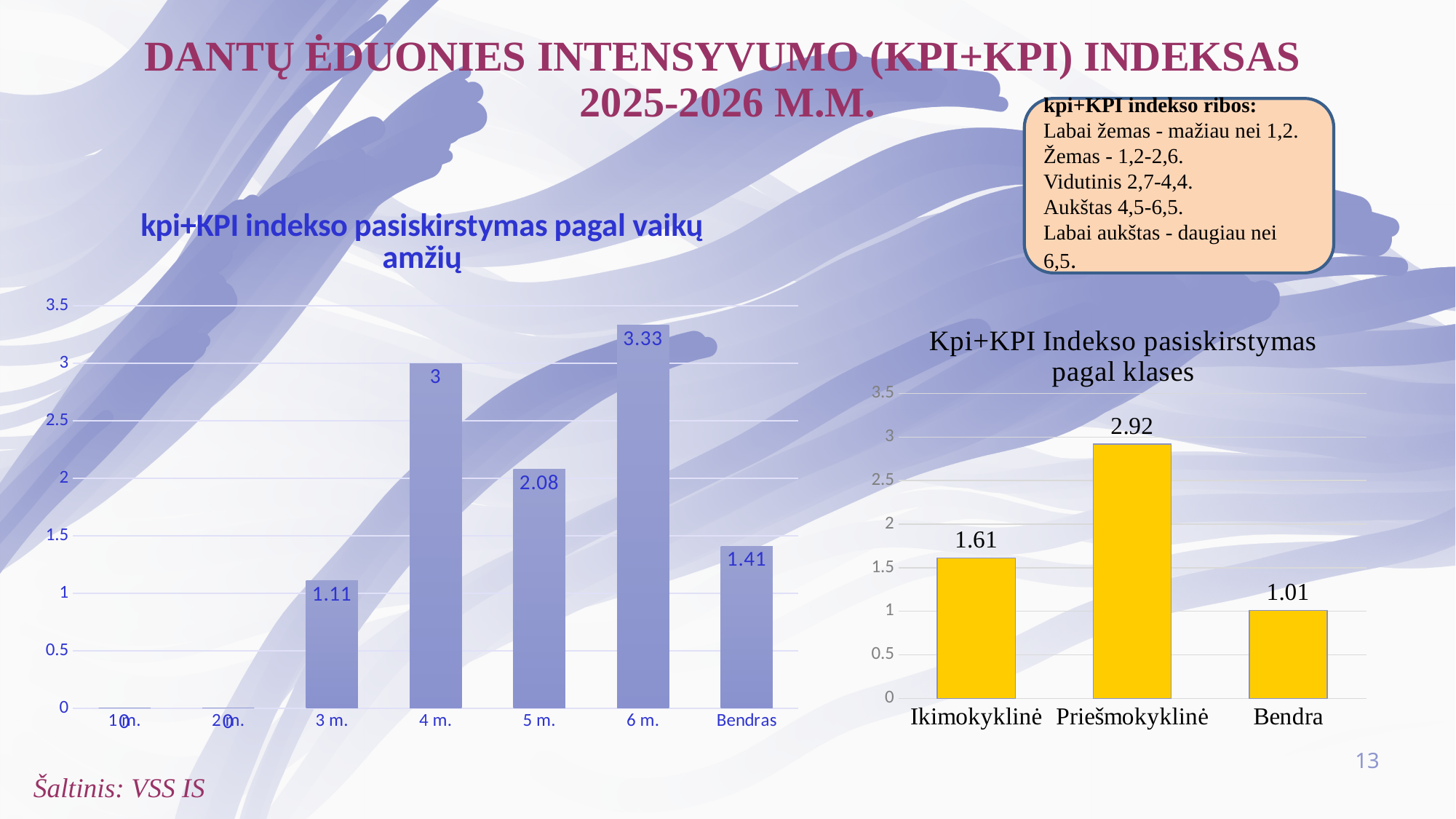
In the chart titled "Kpi+KPI Indekso pasiskirstymas pagal klases", which category has the lowest value? Bendra In the chart titled "kpi+KPI indekso pasiskirstymas pagal vaikų amžių", what is the value for 3 m.? 1.11 In the chart titled "kpi+KPI indekso pasiskirstymas pagal vaikų amžių", what is the difference between the values for 4 m. and 5 m.? 0.92 In the chart titled "Kpi+KPI Indekso pasiskirstymas pagal klases", what is the difference between the values for Priešmokyklinė and Ikimokyklinė? 1.31 In the chart titled "kpi+KPI indekso pasiskirstymas pagal vaikų amžių", which category has the highest value? 6 m. What kind of chart is the chart titled "Kpi+KPI Indekso pasiskirstymas pagal klases"? Bar chart In the chart titled "kpi+KPI indekso pasiskirstymas pagal vaikų amžių", how many categories are shown on the x axis? 7 In the chart titled "kpi+KPI indekso pasiskirstymas pagal vaikų amžių", what is the value for 6 m.? 3.33 In the chart titled "Kpi+KPI Indekso pasiskirstymas pagal klases", what is the value for Priešmokyklinė? 2.92 In the chart titled "Kpi+KPI Indekso pasiskirstymas pagal klases", what colour are the bars? Yellow In the chart titled "kpi+KPI indekso pasiskirstymas pagal vaikų amžių", which is larger, the value for 5 m. or the value for Bendras? 5 m. In the chart titled "kpi+KPI indekso pasiskirstymas pagal vaikų amžių", what is the value for Bendras? 1.41